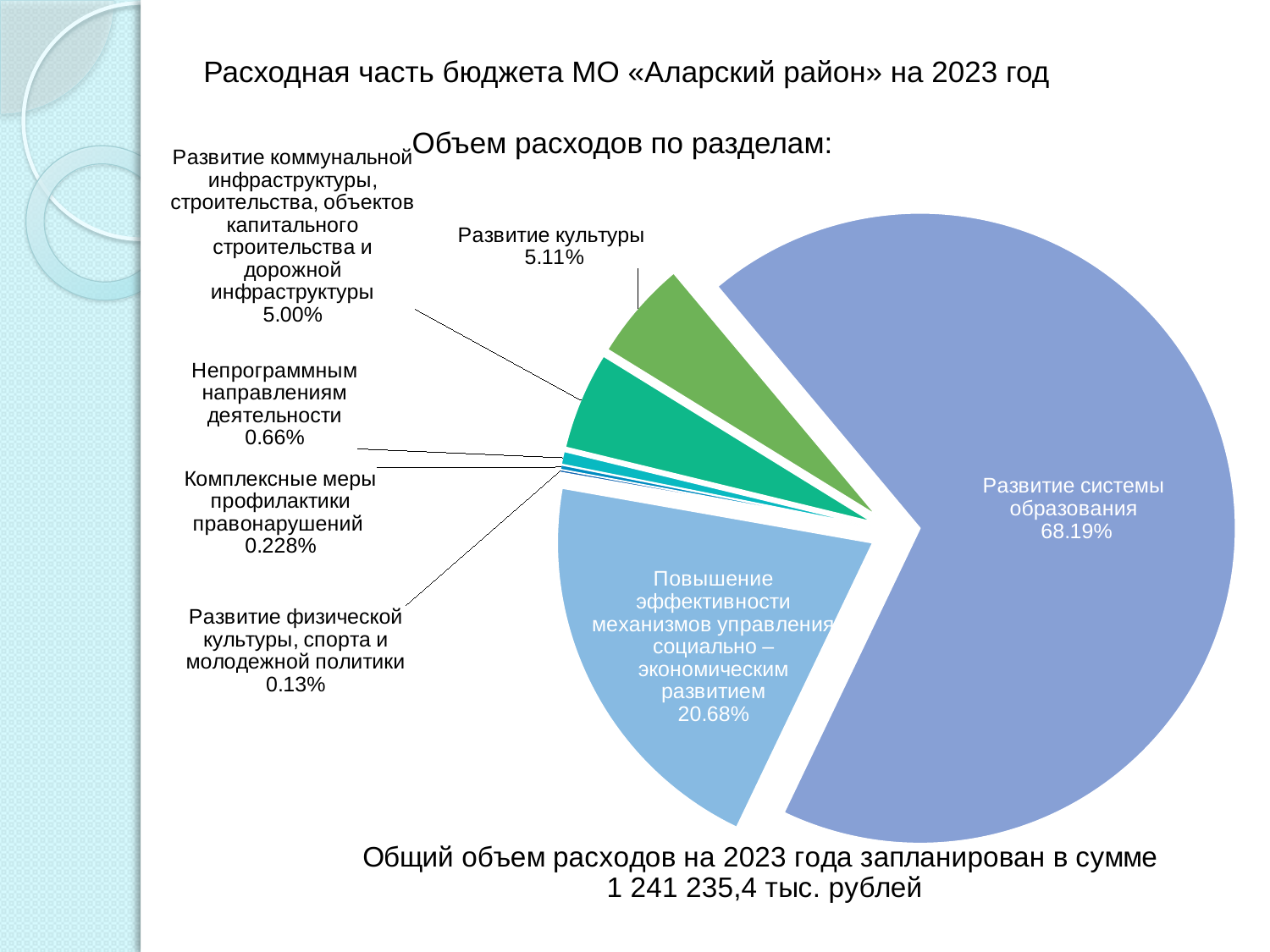
What percentage is shown for «Непрограммным направлениям деятельности»? 0.66% Which section has the largest share of expenditures? Развитие системы образования What type of chart is shown on the slide? pie chart Which section has the smallest share of expenditures? Развитие физической культуры, спорта и молодежной политики What is the title of the pie chart? Объем расходов по разделам: What is the value for «Развитие культуры»? 5.11% How many sections (slices) does the pie chart show? 7 What is the value for «Комплексные меры профилактики правонарушений»? 0.228% What share of expenditures goes to «Развитие системы образования»? 68.19% Which is larger: the share for «Развитие культуры» or for «Развитие коммунальной инфраструктуры, строительства, объектов капитального строительства и дорожной инфраструктуры»? Развитие культуры What is the difference in percentage points between «Развитие системы образования» and «Повышение эффективности механизмов управления социально – экономическим развитием»? 47.51 What percentage is shown for «Повышение эффективности механизмов управления социально – экономическим развитием»? 20.68%